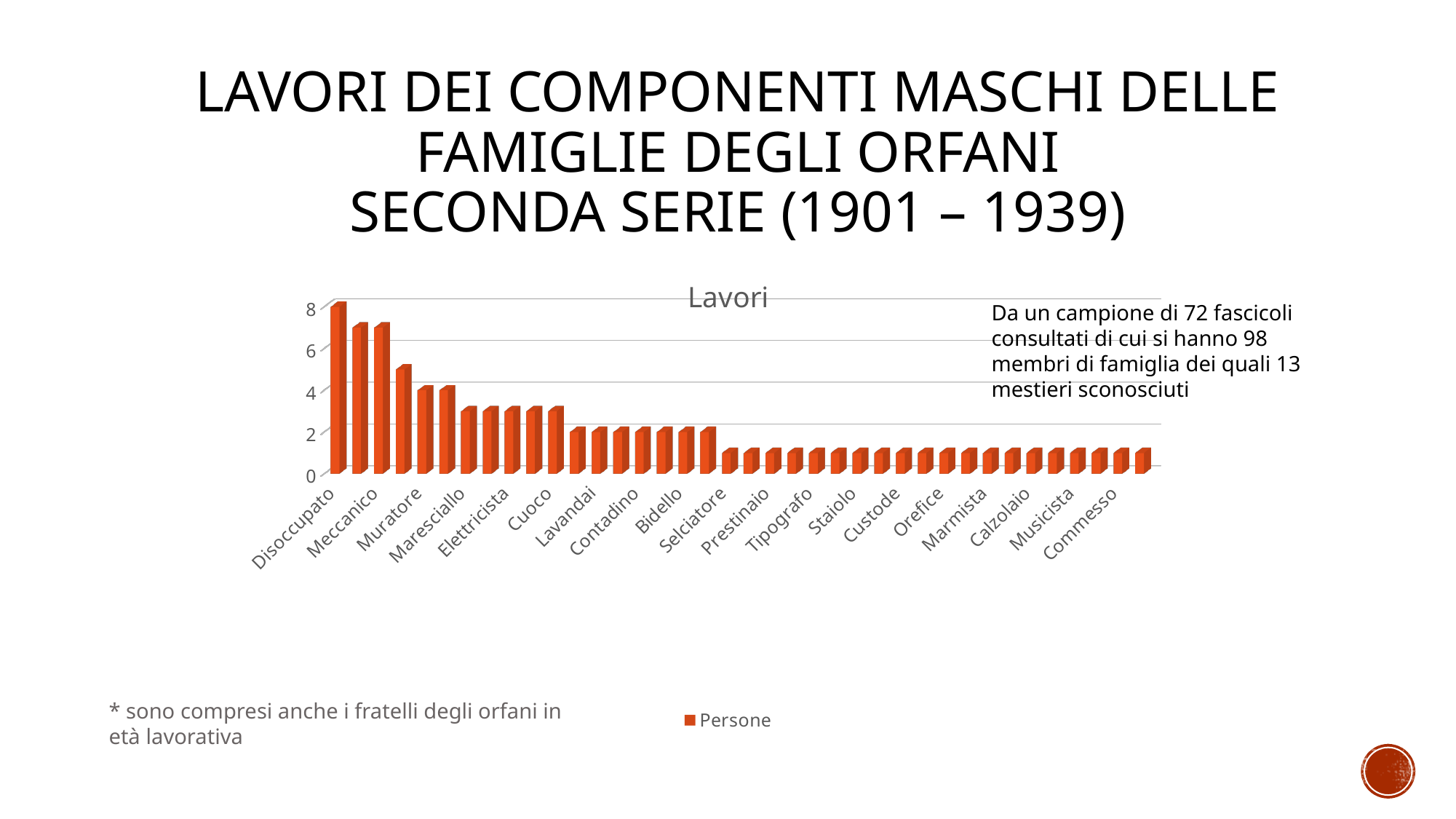
Is the value for Cuoco greater or less than 4? less Which category has the highest value in the chart? Disoccupato Is the value for Commesso greater or less than 2? less How many series does the chart legend list? 1 What is the title of the chart? Lavori What is the value for Disoccupato? 8 What kind of chart is shown on the slide? bar chart What is the name of the series shown in the legend? Persone Is the value for Lavandai greater or less than 4? less Which is larger, the value for Disoccupato or the value for Commesso? Disoccupato Do the values rise or fall moving from left to right along the x axis? fall